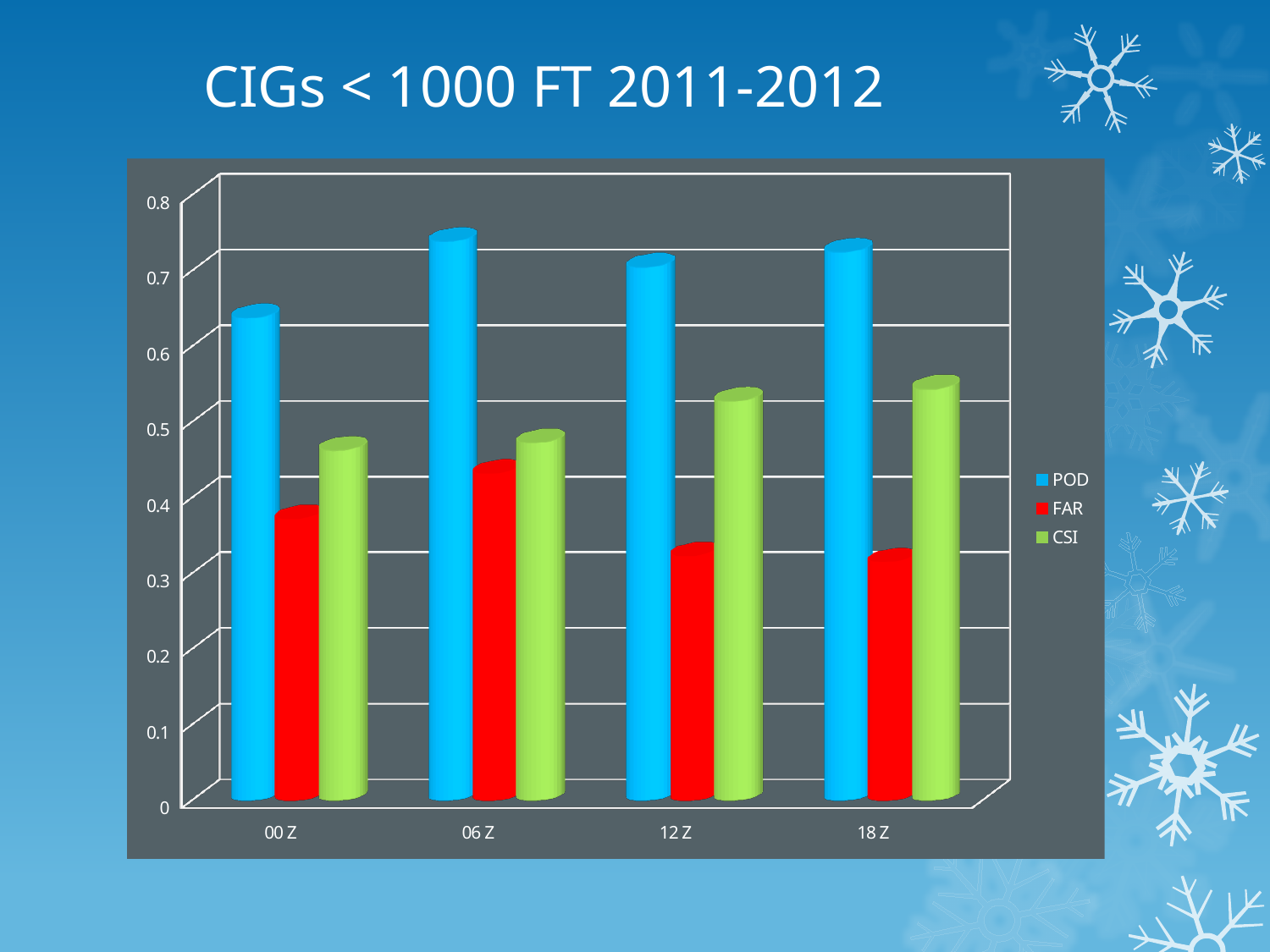
What kind of chart is shown on the slide? bar chart Which category has the lowest POD value? 00 Z Does the CSI value rise or fall from 00 Z to 18 Z? rise How many series does the legend list? 3 Which series is shown in red? FAR What is the title of the chart? CIGs < 1000 FT 2011-2012 Is the FAR value for 12 Z greater or less than 0.4? less Is the CSI value for 18 Z greater or less than 0.5? greater Which category has the highest FAR value? 06 Z Is the POD value for 06 Z greater or less than 0.7? greater Which is larger at 12 Z, the CSI value or the FAR value? CSI How many categories are shown on the x axis? 4